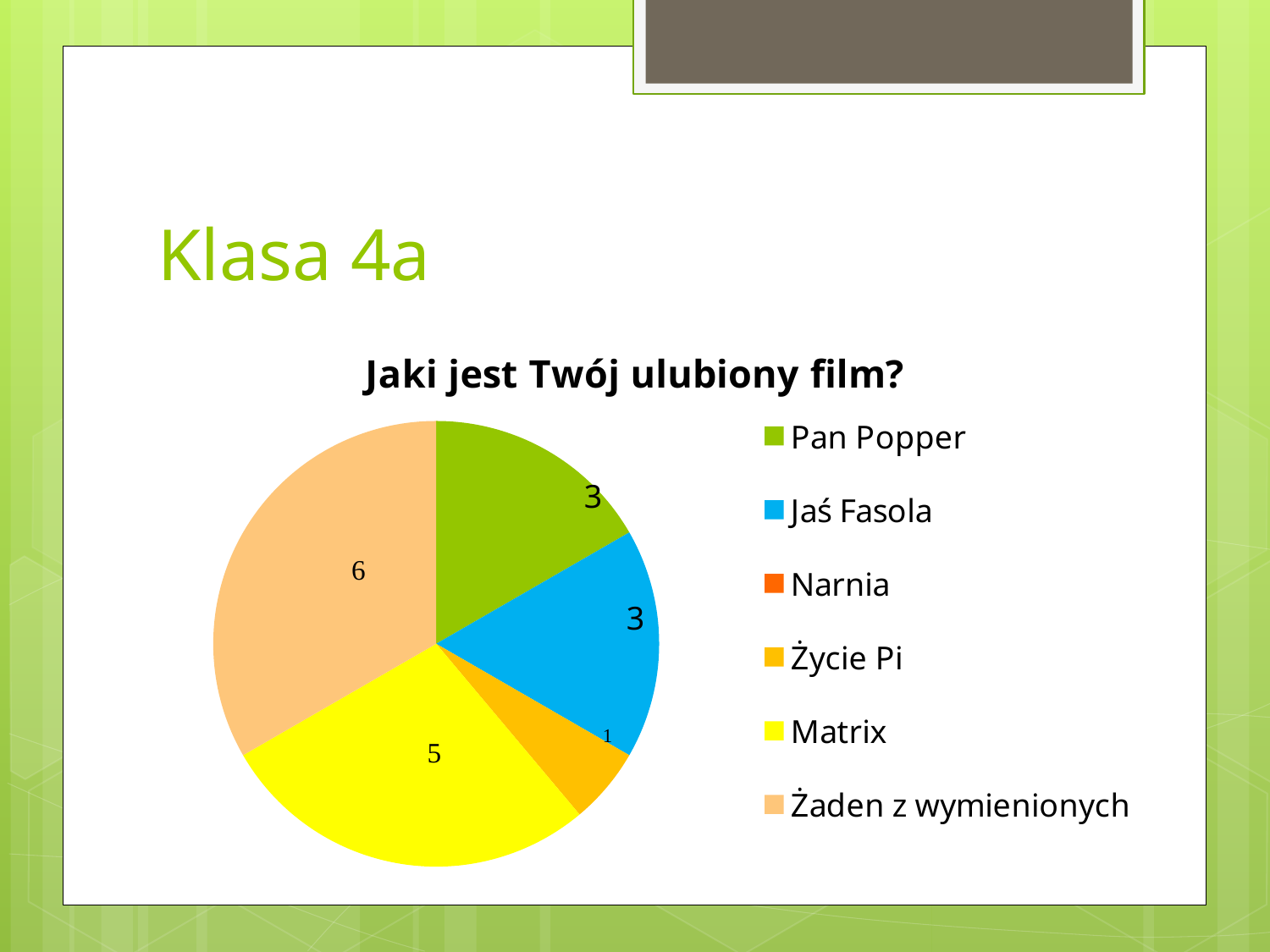
What kind of chart is shown on the slide? pie chart What is the value for Jaś Fasola? 3 What is the value for Żaden z wymienionych? 6 How many entries does the legend list? 6 What is the value for Pan Popper? 3 Which is larger, the value for Matrix or the value for Pan Popper? Matrix What is the difference between the values for Żaden z wymienionych and Matrix? 1 What is the title of the chart? Jaki jest Twój ulubiony film? Which category has the largest slice of the pie? Żaden z wymienionych What is the value for Życie Pi? 1 What is the value for Matrix? 5 Which of the slices with a printed value is the smallest? Życie Pi